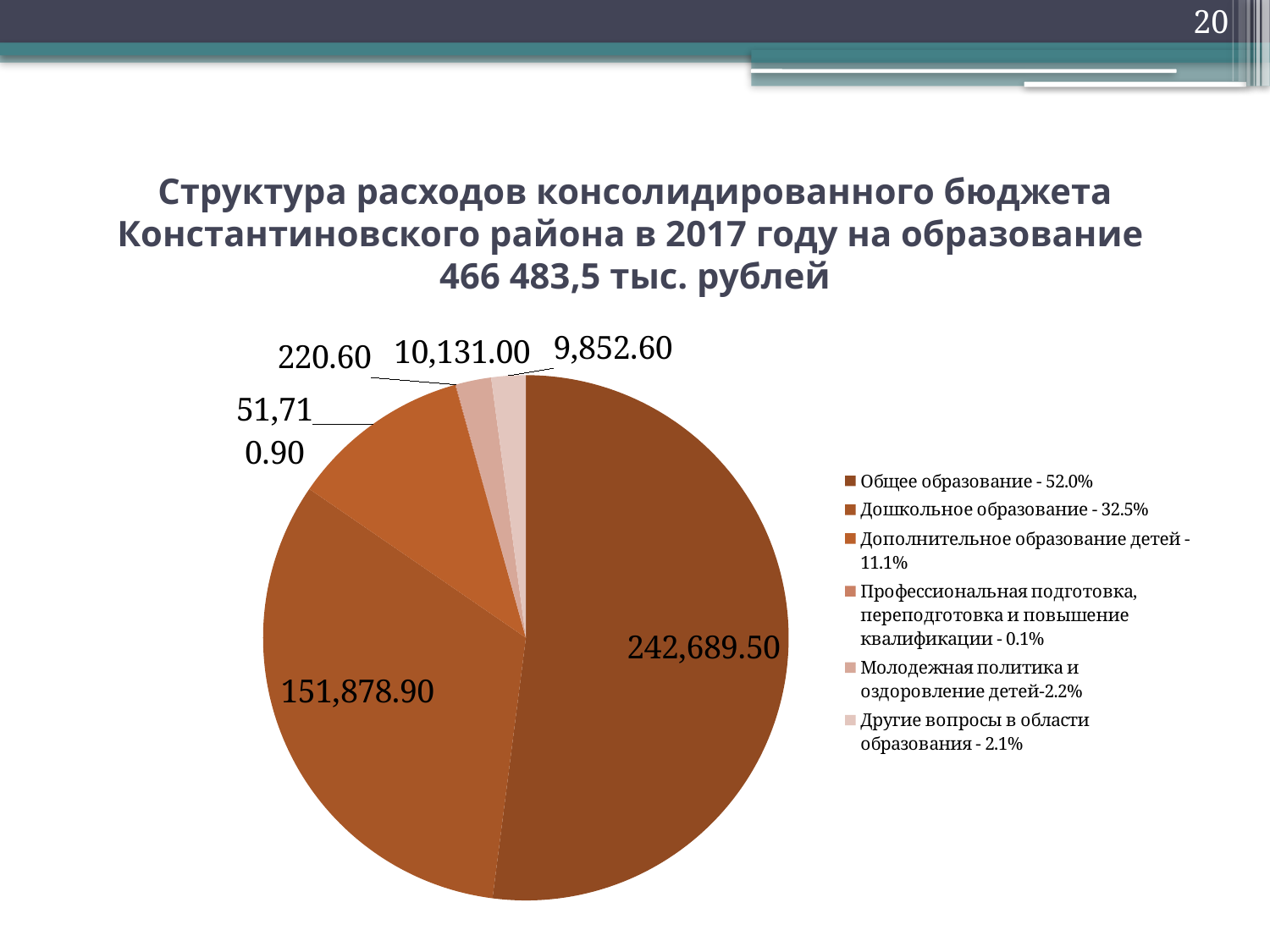
Which category has the smallest slice of the pie? Профессиональная подготовка, переподготовка и повышение квалификации What is the value for Профессиональная подготовка, переподготовка и повышение квалификации? 220.60 Which is larger, the value for Молодежная политика и оздоровление детей or the value for Другие вопросы в области образования? Молодежная политика и оздоровление детей What is the value for Другие вопросы в области образования? 9,852.60 Which category has the largest slice of the pie? Общее образование How many categories does the pie chart have? 6 What kind of chart is shown on the slide? pie chart What is the value for Общее образование? 242,689.50 What is the value for Молодежная политика и оздоровление детей? 10,131.00 What is the value for Дошкольное образование? 151,878.90 What is the difference between the values for Общее образование and Дошкольное образование? 90,810.60 What share of the pie does Дошкольное образование represent, according to the legend? 32.5%